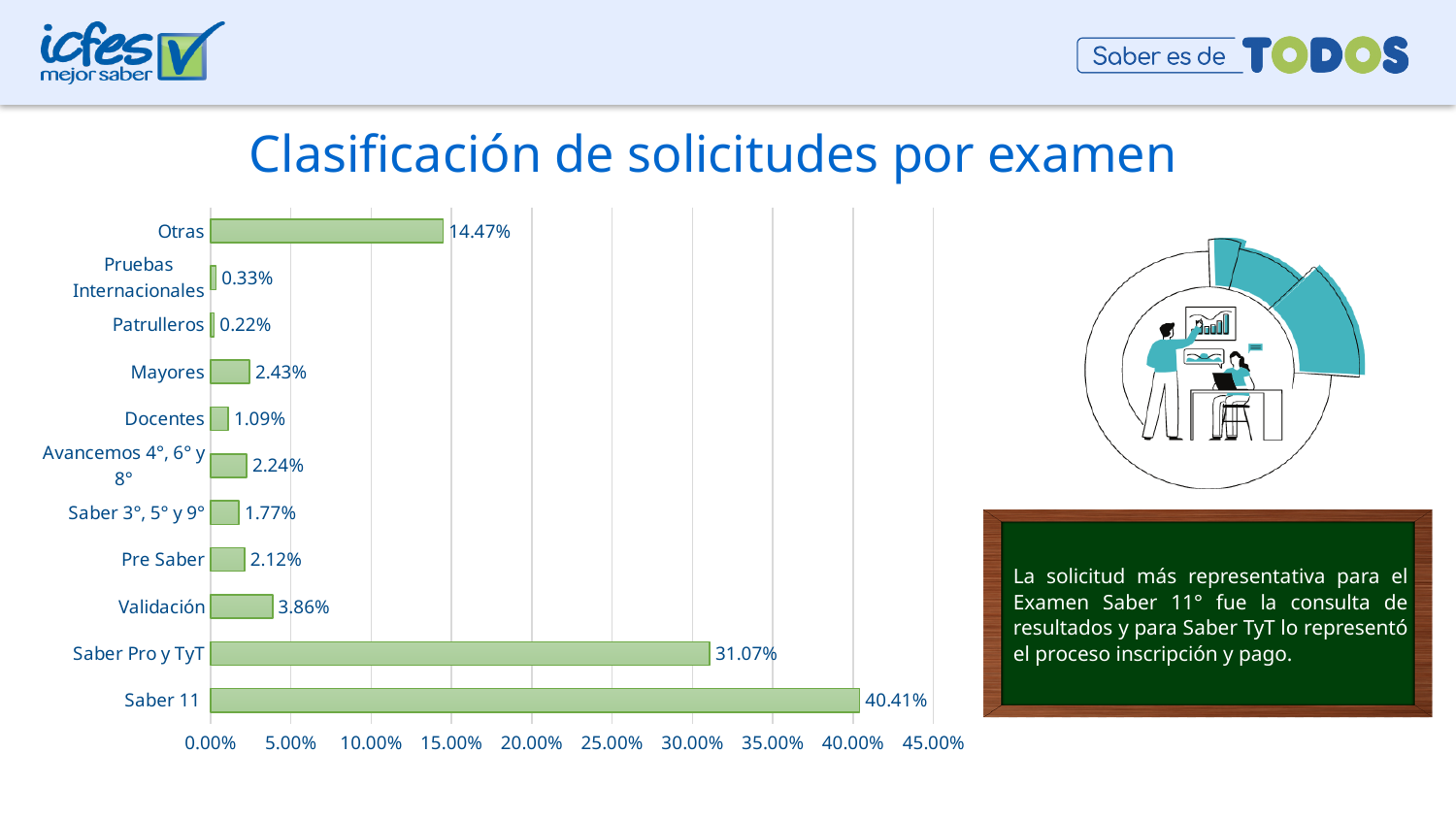
Which is larger, the value for Mayores or the value for Avancemos 4°, 6° y 8°? Mayores What is the value for Saber Pro y TyT? 31.07% Which category has the highest value? Saber 11 What is the difference between the values for Saber 11 and Saber Pro y TyT? 9.34% What is the value for Validación? 3.86% What is the value for Saber 11? 40.41% What is the title of the chart? Clasificación de solicitudes por examen What kind of chart is shown on the slide? Bar chart Is the value for Otras greater or less than 15.00%? less How many categories are shown in the chart? 11 Which category has the lowest value? Patrulleros What is the value for Otras? 14.47%